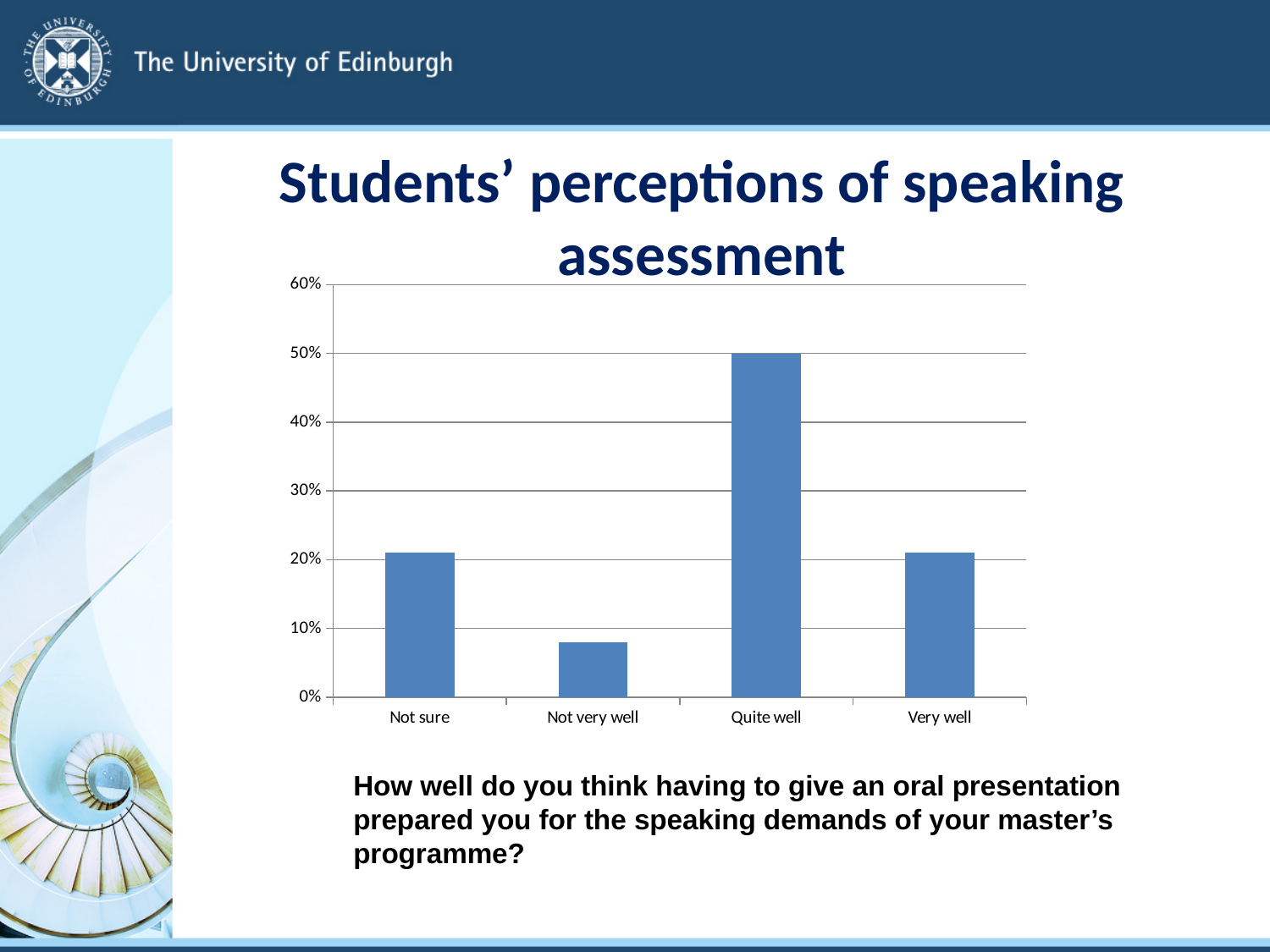
How many categories are shown on the x axis of the chart? 4 What is the value for "Quite well"? 50% Which is larger, the value for "Not sure" or the value for "Not very well"? Not sure What type of chart is shown on the slide? bar chart Which category has the highest value in the chart? Quite well What is the title of the chart? Students' perceptions of speaking assessment Is the value for "Very well" greater or less than 10%? greater Is the value for "Not sure" greater or less than 30%? less Which category has the lowest value in the chart? Not very well Is the value for "Quite well" greater or less than 40%? greater Which is larger, the value for "Quite well" or the value for "Very well"? Quite well